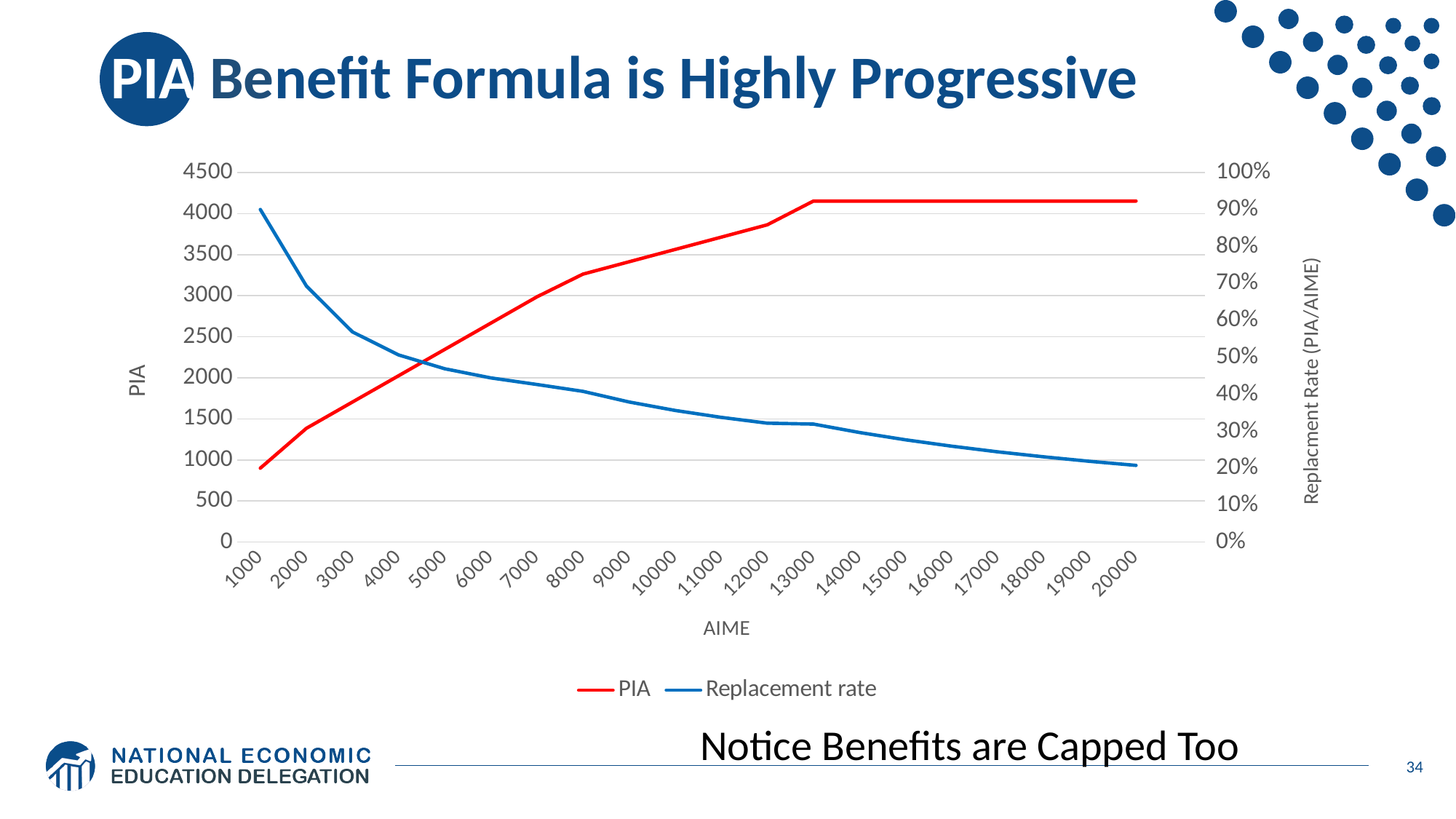
At which AIME value is PIA lowest? 1000 What kind of chart is shown on the slide? Line chart At which AIME value is the Replacement rate highest? 1000 Does the PIA line rise or fall as AIME increases? Rises What is the label on the x axis of the chart? AIME At which AIME value is the Replacement rate lowest? 20000 Is the Replacement rate at AIME 20000 greater or less than 30%? less Does the Replacement rate line rise or fall as AIME increases? Falls How many series does the legend list? 2 Is the Replacement rate at AIME 1000 greater or less than 80%? greater Is the PIA value at AIME 20000 greater or less than 4000? greater How many AIME values are labelled along the x axis? 20